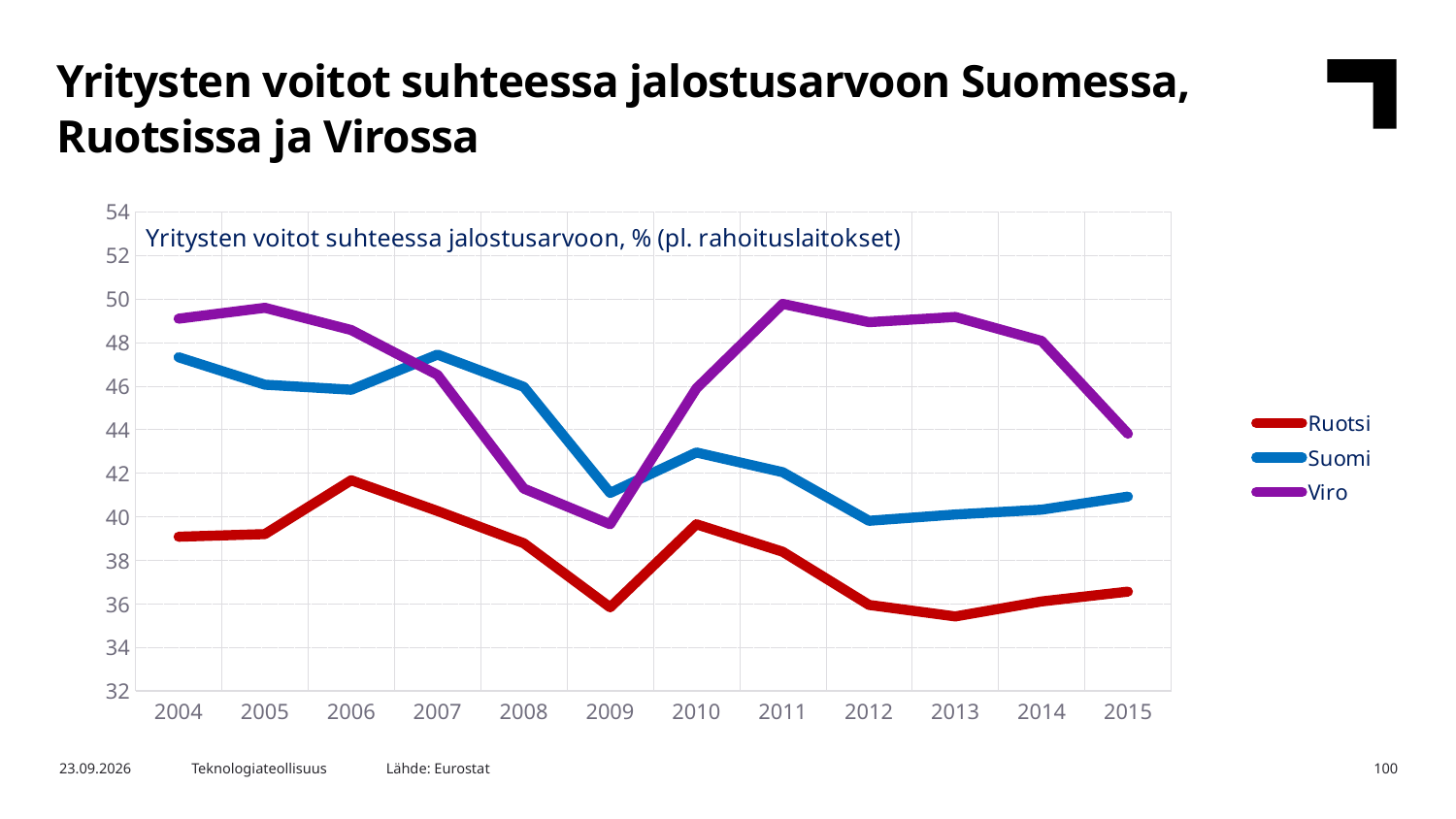
In which year does Viro reach its lowest value? 2009 How many series does the legend list? 3 In 2008, which series has the highest value? Suomi How many years are plotted along the x axis? 12 Which series is plotted in red? Ruotsi Is the value for Ruotsi in 2009 greater or less than 38? less Is the value for Suomi in 2012 greater or less than 42? less What kind of chart is shown on the slide? line chart What is the title shown inside the chart area? Yritysten voitot suhteessa jalostusarvoon, % (pl. rahoituslaitokset) In 2015, which is larger, the value for Viro or the value for Suomi? Viro Does the value for Viro rise or fall from 2011 to 2015? fall Is the value for Viro in 2011 greater or less than 48? greater